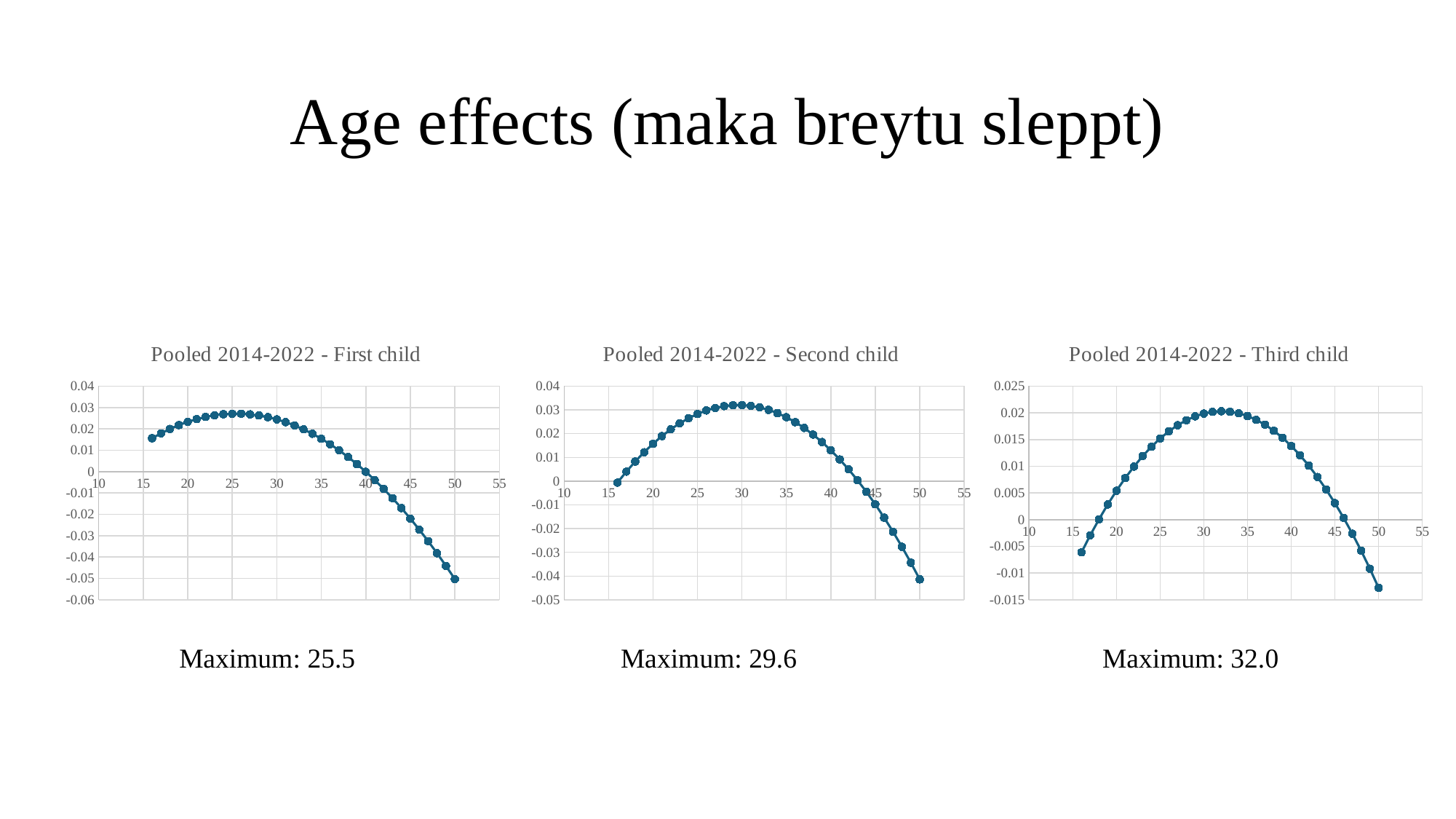
In the 'Pooled 2014-2022 - Third child' chart, which is larger, the value at age 20 or the value at age 50? age 20 In the 'Pooled 2014-2022 - First child' chart, is the value at age 16 greater or less than 0.01? greater In the 'Pooled 2014-2022 - Second child' chart, which is larger, the value at age 16 or the value at age 30? age 30 In the 'Pooled 2014-2022 - Third child' chart, is the value at age 16 greater or less than 0? less In the 'Pooled 2014-2022 - Second child' chart, do the values rise or fall between age 35 and age 50? fall What is the title of the rightmost chart on the slide? Pooled 2014-2022 - Third child In the 'Pooled 2014-2022 - First child' chart, which is larger, the value at age 20 or the value at age 40? age 20 In the 'Pooled 2014-2022 - Third child' chart, is the value at age 50 greater or less than -0.01? less What kind of chart is the 'Pooled 2014-2022 - First child' chart? line chart